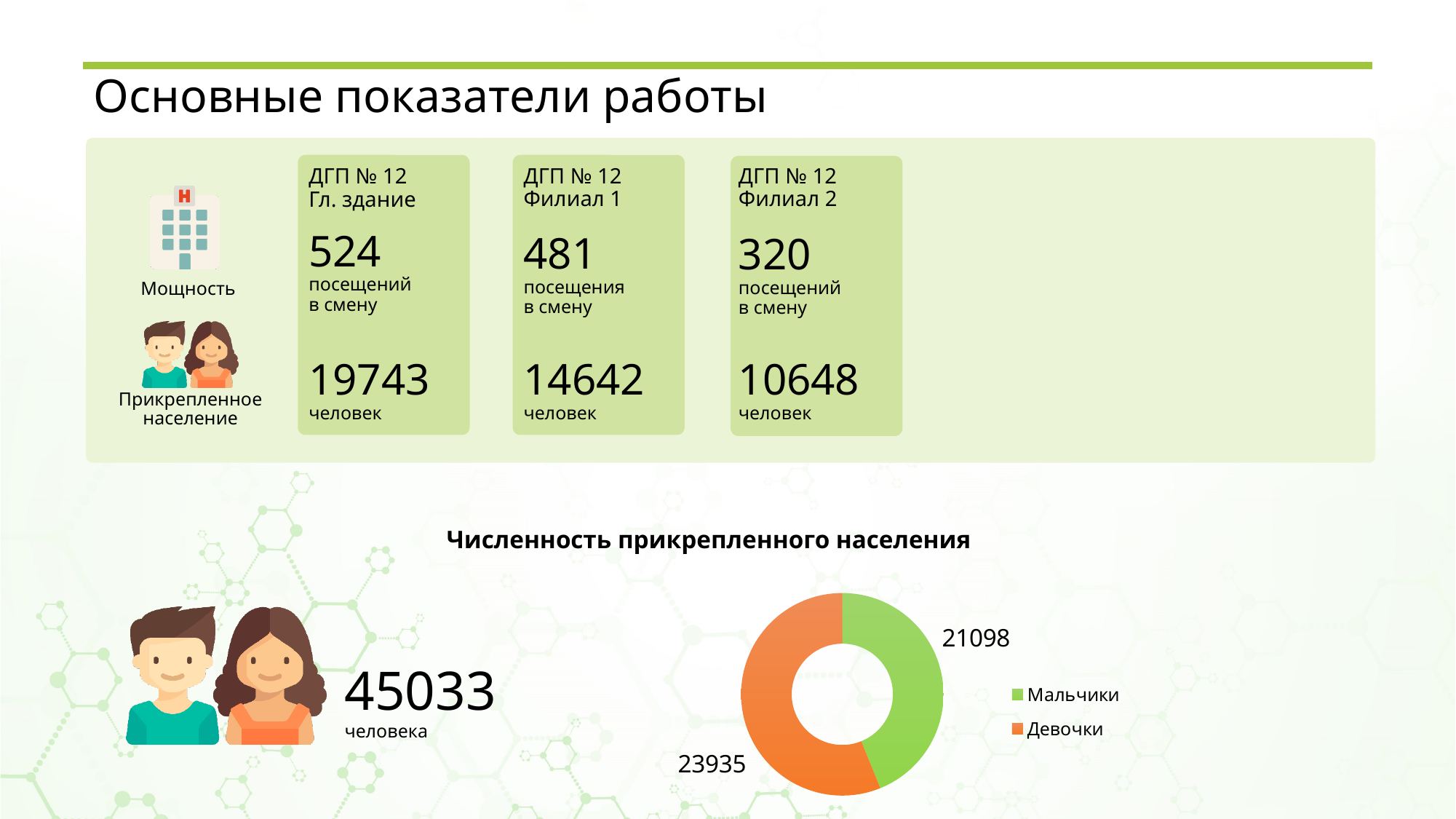
How many slices does the donut chart have? 2 What is the title of the chart on the slide? Численность прикрепленного населения Which is larger in the donut chart, Мальчики or Девочки? Девочки What is the difference between the values for Девочки and Мальчики in the donut chart? 2837 Which category has the largest slice in the donut chart? Девочки What is the total of the two slices in the donut chart? 45033 What kind of chart is shown at the bottom of the slide? Donut (pie) chart What is the value for Мальчики in the donut chart? 21098 What colour is the Девочки slice in the donut chart? Orange Which category has the smallest slice in the donut chart? Мальчики How many entries does the legend of the donut chart list? 2 What is the value for Девочки in the donut chart? 23935